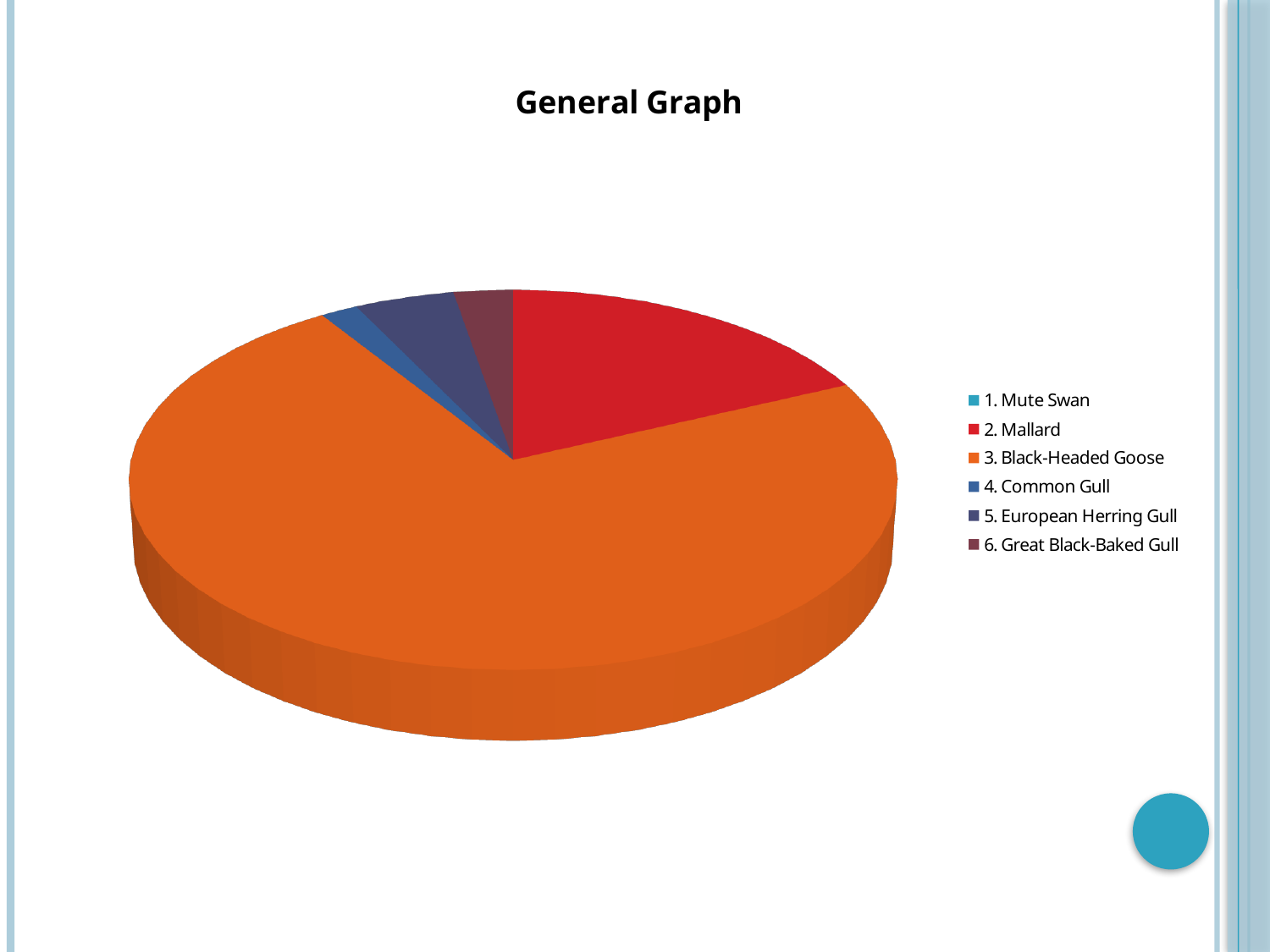
Which category is shown in red in the legend? 2. Mallard How many categories does the legend list? 6 Which is larger, the slice for 2. Mallard or the slice for 6. Great Black-Baked Gull? 2. Mallard Which category is the second-largest slice of the pie? 2. Mallard What is the title of the chart? General Graph Which is larger, the slice for 2. Mallard or the slice for 3. Black-Headed Goose? 3. Black-Headed Goose Which is larger, the slice for 2. Mallard or the slice for 5. European Herring Gull? 2. Mallard What kind of chart is shown on the slide? pie chart Which category has the largest slice of the pie? 3. Black-Headed Goose